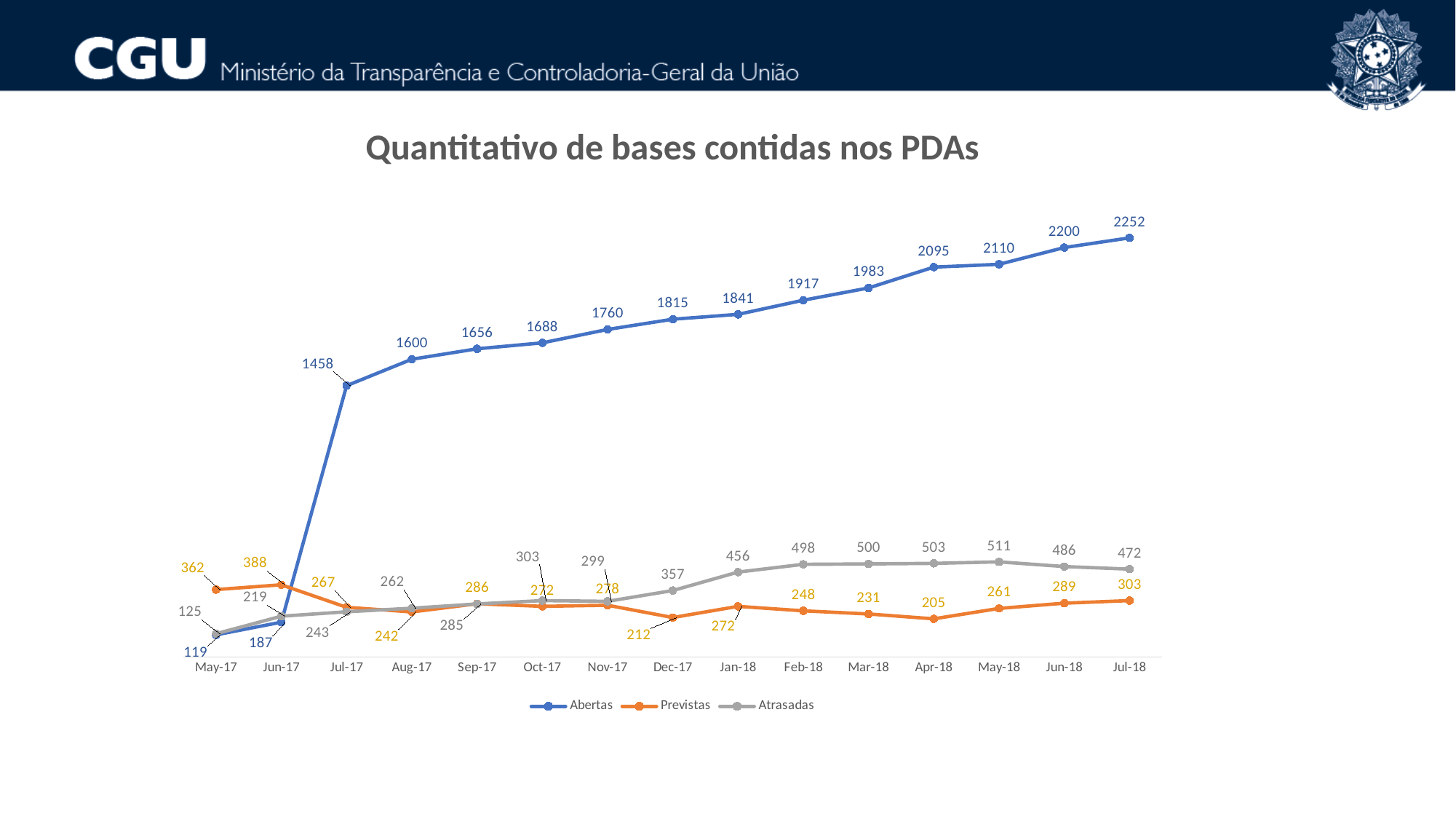
What is the value of Abertas in Jul-18? 2252 How many months are plotted along the x axis? 15 In which month does the Previstas series reach its lowest value? Apr-18 What is the title of the chart? Quantitativo de bases contidas nos PDAs Does the Abertas series generally rise or fall from May-17 to Jul-18? Rise In which month does the Atrasadas series reach its highest value? May-18 What kind of chart is shown on the slide? Line chart In Jan-18, which is larger: Atrasadas or Previstas? Atrasadas What is the value of Previstas in Apr-18? 205 By how much did Abertas increase from Jun-18 to Jul-18? 52 How many series does the legend list? 3 What is the value of Atrasadas in May-18? 511